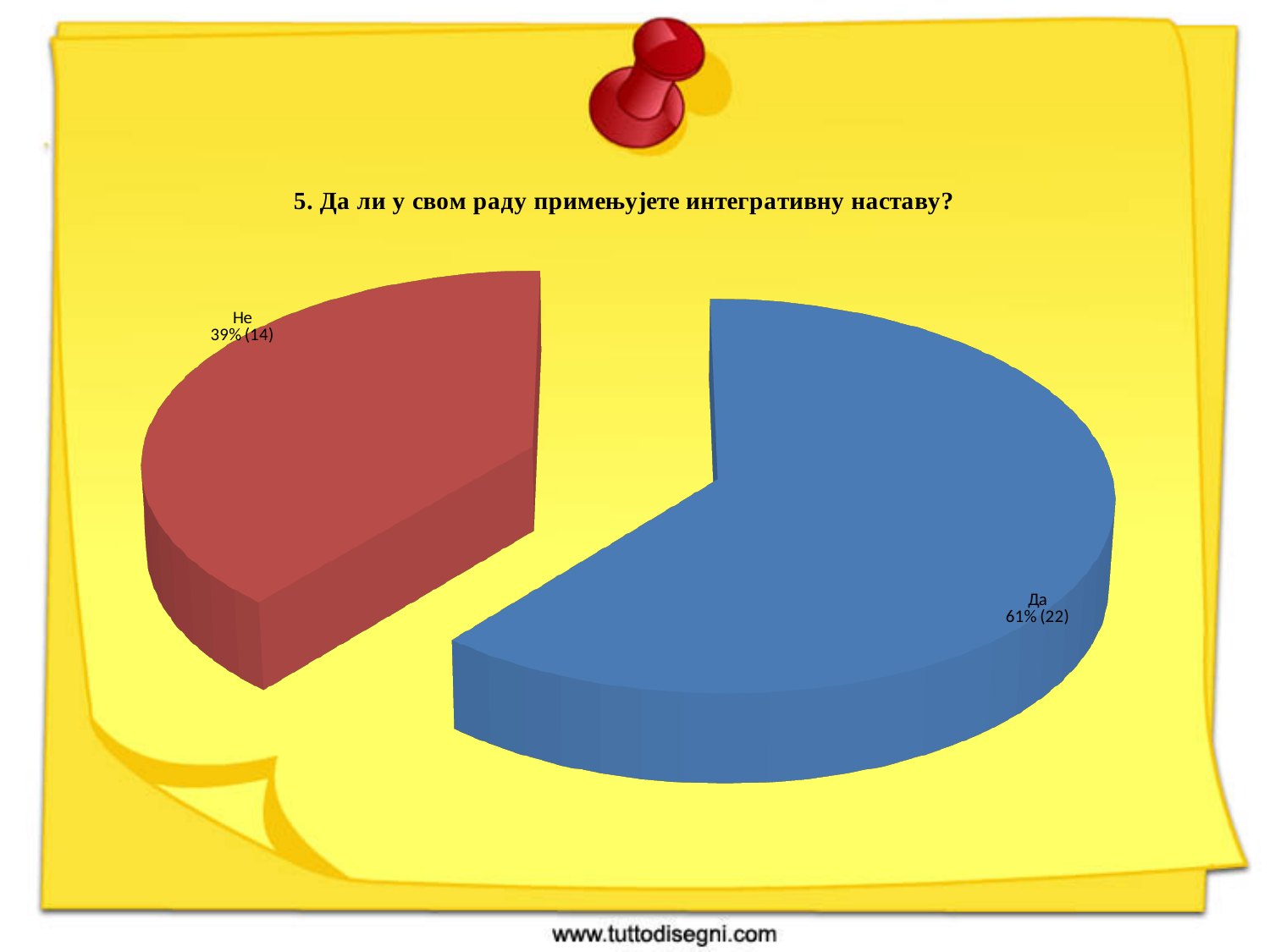
What colour is the "Не" slice? Red How many slices does the pie chart have? 2 What is the difference in percentage points between "Да" and "Не"? 22 How many respondents answered "Да"? 22 Which answer has the largest share of the pie? Да What percentage of respondents answered "Да"? 61% What percentage of respondents answered "Не"? 39% Which answer has the smallest share of the pie? Не How many more respondents answered "Да" than "Не"? 8 What kind of chart is shown on the slide? Pie chart How many respondents answered "Не"? 14 Which is larger, the share for "Да" or the share for "Не"? Да